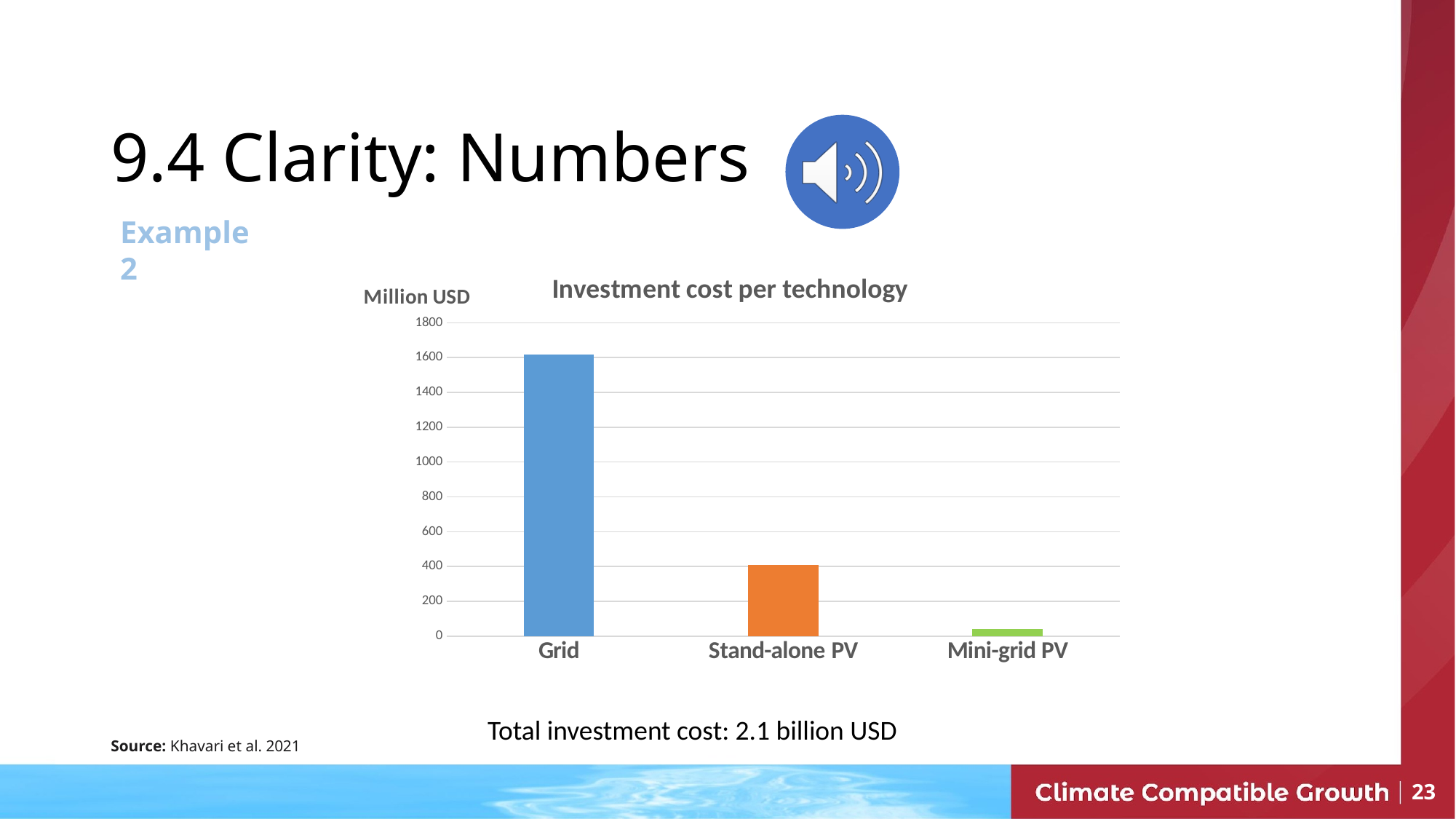
Is the value for Stand-alone PV greater or less than 600? less Which has a larger investment cost, Stand-alone PV or Mini-grid PV? Stand-alone PV How many technologies are shown on the x axis of the chart? 3 What kind of chart is shown on the slide? bar chart Is the value for Grid greater or less than 1400? greater Which has a larger investment cost, Grid or Stand-alone PV? Grid Is the value for Mini-grid PV greater or less than 200? less Which technology has the highest investment cost? Grid What is the title of the chart? Investment cost per technology Which technology has the lowest investment cost? Mini-grid PV What unit is shown on the y axis of the chart? Million USD